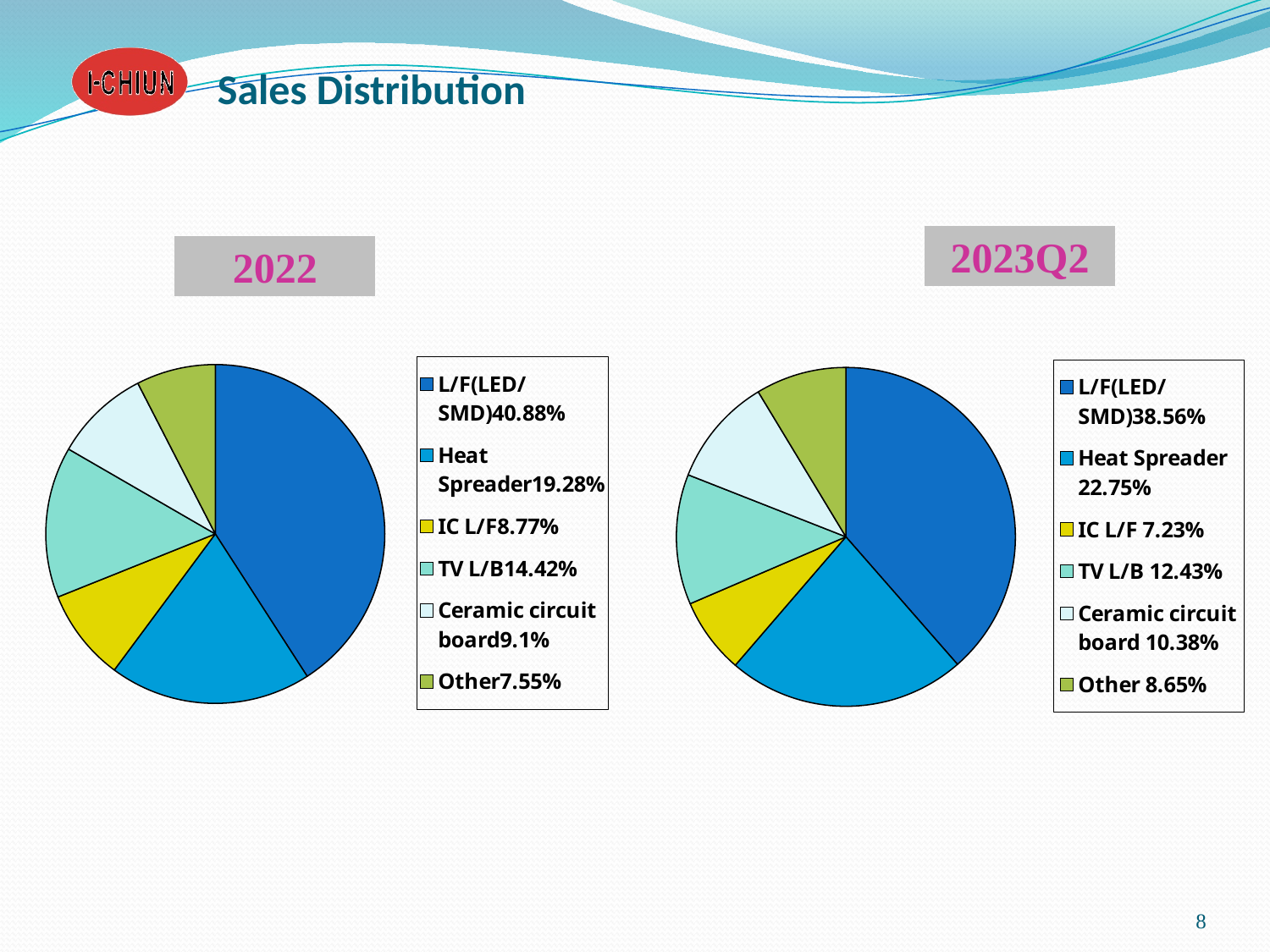
In the 2022 pie chart, which category has the smallest share? Other In the 2022 pie chart, which is larger: TV L/B or IC L/F? TV L/B In the 2023Q2 pie chart, which category has the smallest share? IC L/F In the 2023Q2 pie chart, what share does Other have? 8.65% In the 2022 pie chart, which category has the largest share? L/F(LED/SMD) What is the difference between the Heat Spreader share in 2023Q2 and in 2022? 3.47% In the 2022 pie chart, what share does L/F(LED/SMD) have? 40.88% What type of chart is used for the 2022 sales distribution? Pie chart How many categories does the 2023Q2 pie chart have? 6 In the 2023Q2 pie chart, what share does Heat Spreader have? 22.75% In the 2022 pie chart, what share does Ceramic circuit board have? 9.1% What is the title of the slide? Sales Distribution